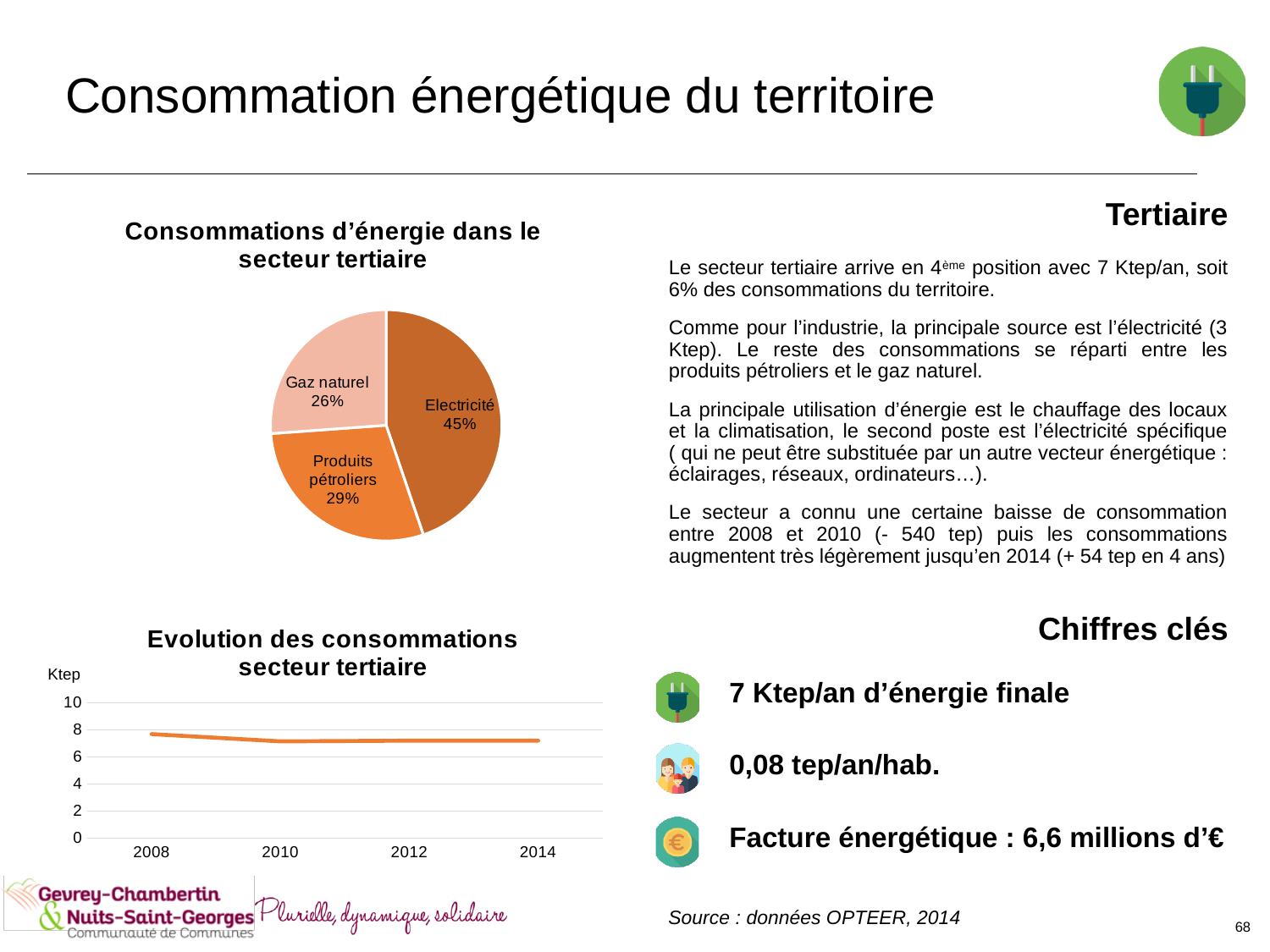
What kind of chart is 'Evolution des consommations secteur tertiaire'? Line chart In the pie chart 'Consommations d'énergie dans le secteur tertiaire', what share do Produits pétroliers have? 29% How many slices does the pie chart 'Consommations d'énergie dans le secteur tertiaire' have? 3 In the pie chart 'Consommations d'énergie dans le secteur tertiaire', which energy source has the largest share? Electricité In the pie chart 'Consommations d'énergie dans le secteur tertiaire', what is the difference in percentage points between Electricité and Gaz naturel? 19 percentage points What unit is shown on the y axis of the chart 'Evolution des consommations secteur tertiaire'? Ktep In the pie chart 'Consommations d'énergie dans le secteur tertiaire', which is larger: Produits pétroliers or Gaz naturel? Produits pétroliers In the pie chart 'Consommations d'énergie dans le secteur tertiaire', what share does Electricité have? 45% In the chart 'Evolution des consommations secteur tertiaire', is the value for 2014 greater or less than 8 Ktep? less In the chart 'Evolution des consommations secteur tertiaire', is the value for 2008 greater or less than 6 Ktep? greater In the pie chart 'Consommations d'énergie dans le secteur tertiaire', what share does Gaz naturel have? 26% In the pie chart 'Consommations d'énergie dans le secteur tertiaire', which energy source has the smallest share? Gaz naturel